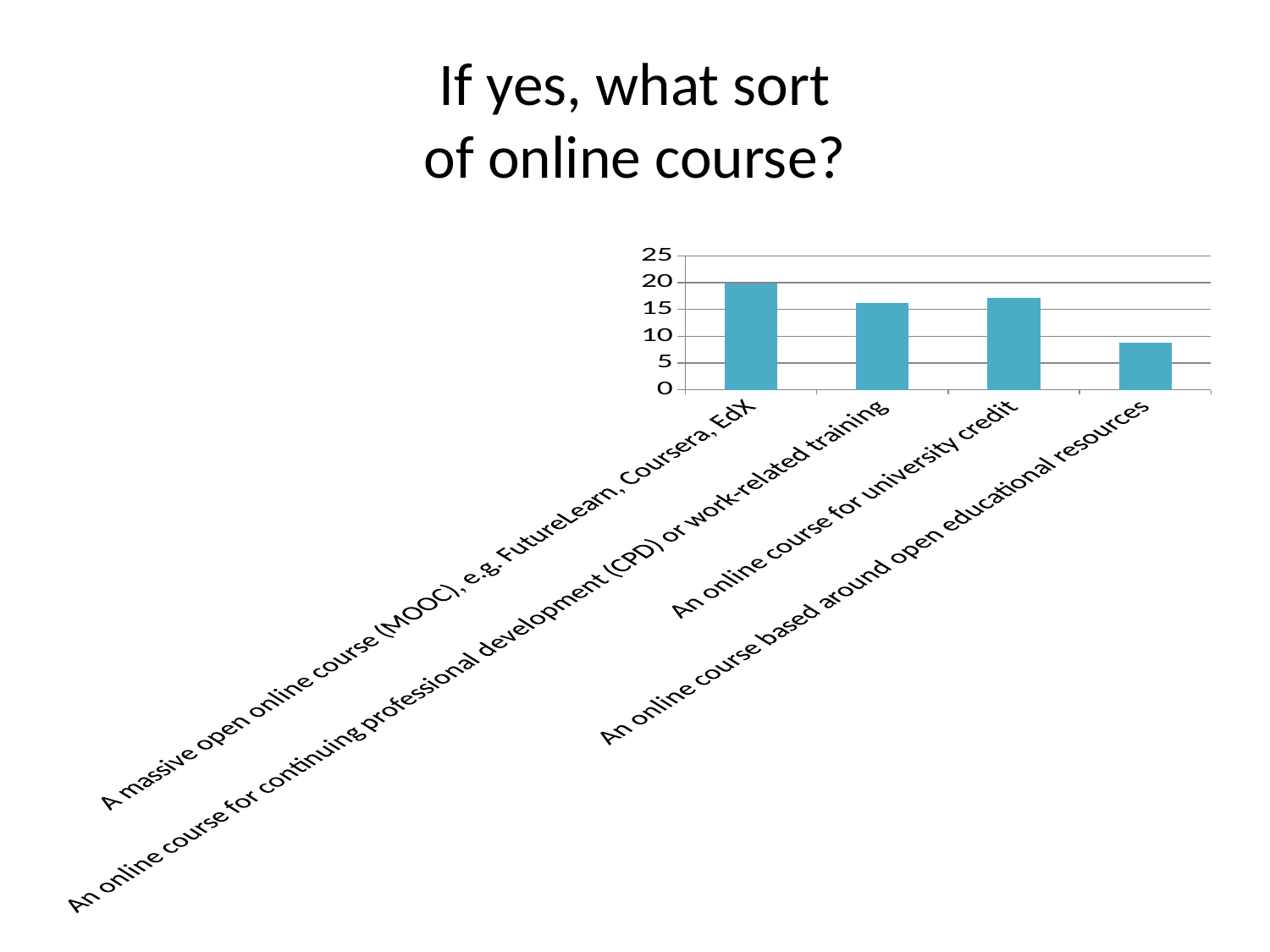
Which category has the highest bar? A massive open online course (MOOC), e.g. FutureLearn, Coursera, EdX Is the value for 'An online course based around open educational resources' greater or less than 10? less How many categories are plotted in the chart? 4 Is the value for 'An online course for continuing professional development (CPD) or work-related training' greater or less than 20? less Is the value for 'An online course based around open educational resources' greater or less than 5? greater What is the title of the slide containing the chart? If yes, what sort of online course? Which category has the lowest bar? An online course based around open educational resources Which is larger: the value for 'A massive open online course (MOOC), e.g. FutureLearn, Coursera, EdX' or the value for 'An online course based around open educational resources'? A massive open online course (MOOC), e.g. FutureLearn, Coursera, EdX What kind of chart is shown on the slide? bar chart